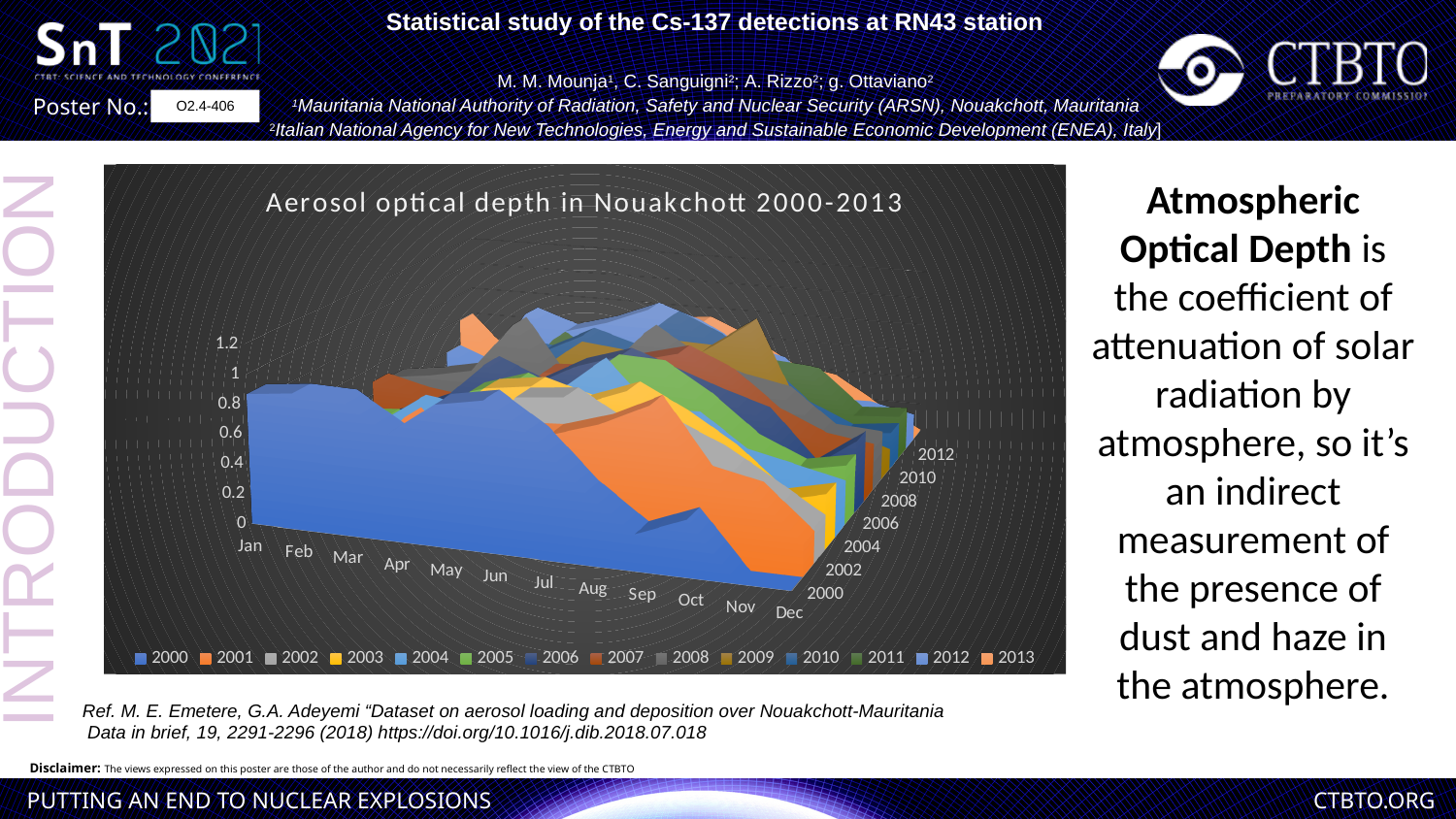
How many months are shown along the x axis of the chart? 12 Which years are covered by the series in the chart's legend? 2000 to 2013 How many series does the chart's legend list? 14 What is the highest tick value shown on the vertical axis of the chart? 1.2 Is the value for 2000 in Jan greater or less than 0.4? greater What is the title of the chart on the slide? Aerosol optical depth in Nouakchott 2000-2013 What kind of chart is shown on the slide? 3D area chart